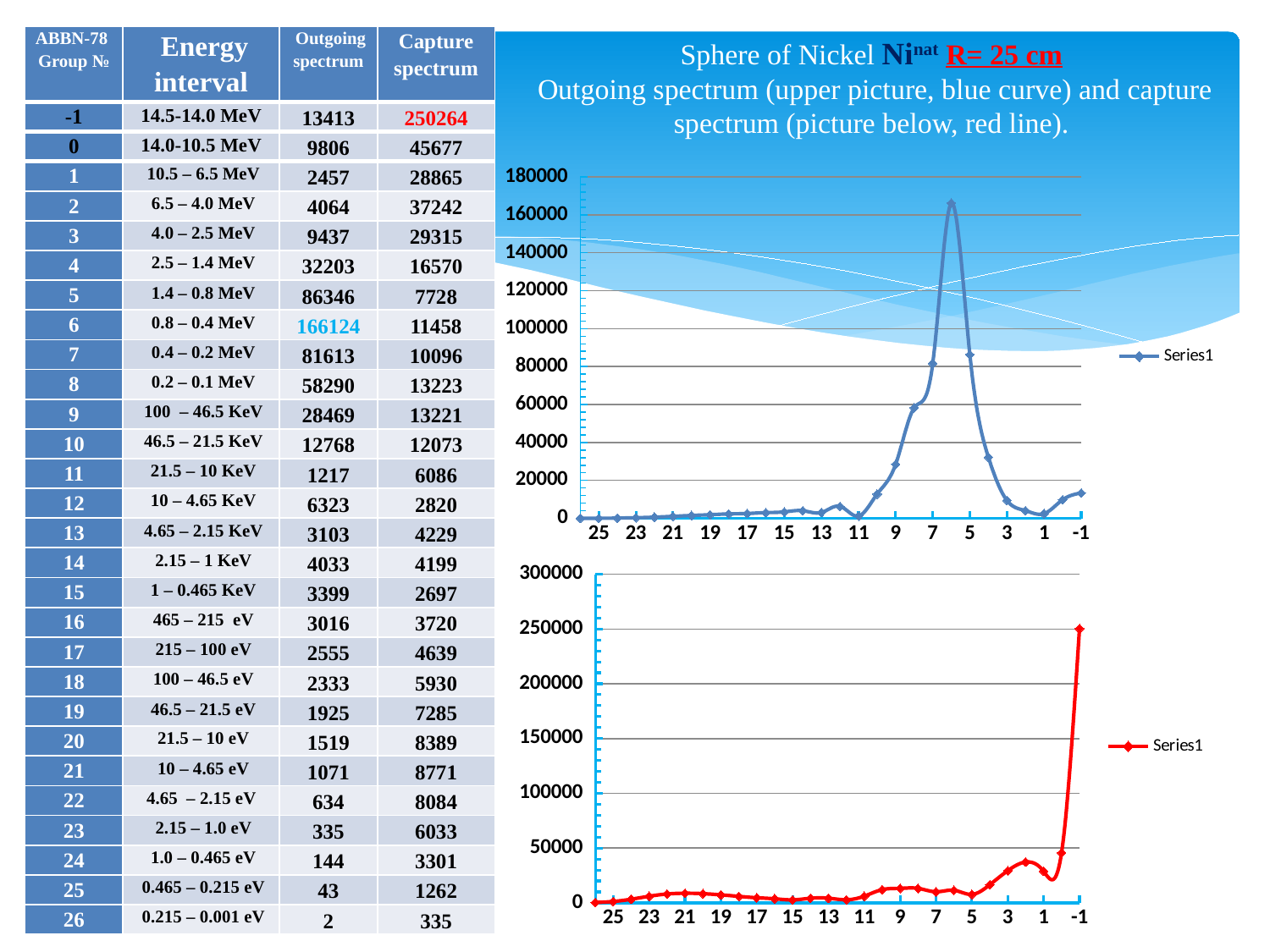
In the upper chart, is the value at group 11 greater or less than 20000? less In the lower chart, what is the name of the series shown in the legend? Series1 In the lower chart, do the values rise or fall moving along the x axis from group 5 to group -1? rise In the upper chart, which has the larger value: group 7 or group 9? group 7 In the upper chart, is the value at group 6 greater or less than 140000? greater What kind of chart is the upper chart on the slide? line chart In the lower chart, at which group number on the x axis does the curve reach its highest value? -1 In the lower chart, which has the larger value: group 3 or group 9? group 3 In the upper chart, how many series does the legend list? 1 In the lower chart, is the value at group -1 greater or less than 200000? greater What kind of chart is the lower chart on the slide? line chart In the upper chart, at which group number on the x axis does the curve reach its highest value? 6